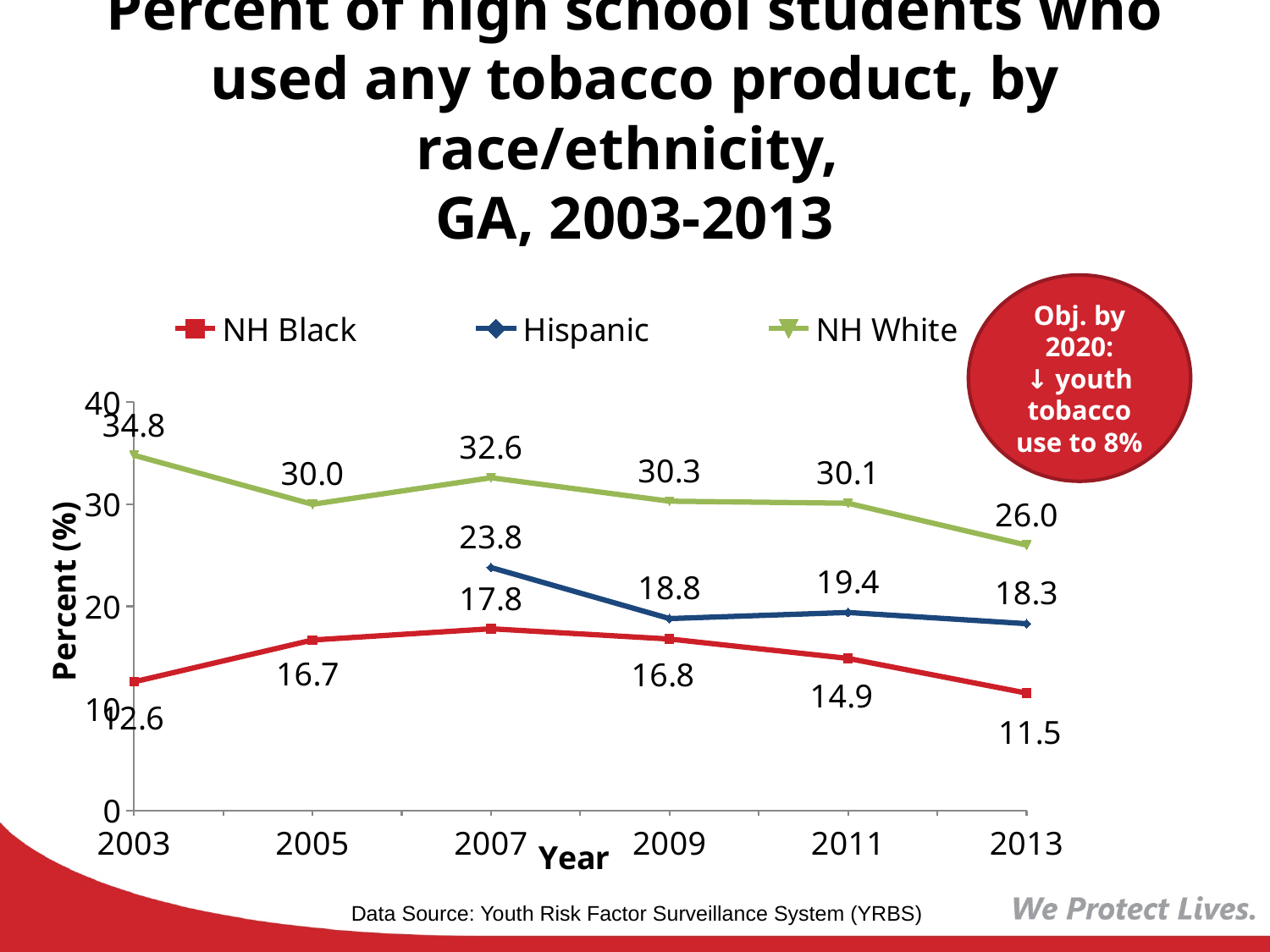
What is the value for NH White in 2003? 34.8 In which year is the NH Black value highest? 2007 What is the label of the y axis? Percent (%) What kind of chart is shown? Line chart Which is larger in 2011, the Hispanic value or the NH Black value? Hispanic How many years are shown on the x axis? 6 What is the value for NH Black in 2013? 11.5 Does the NH White value rise or fall from 2011 to 2013? Fall What is the difference between the NH White and NH Black values in 2013? 14.5 What is the value for Hispanic in 2007? 23.8 In which year is the NH White value lowest? 2013 How many series does the legend list? 3